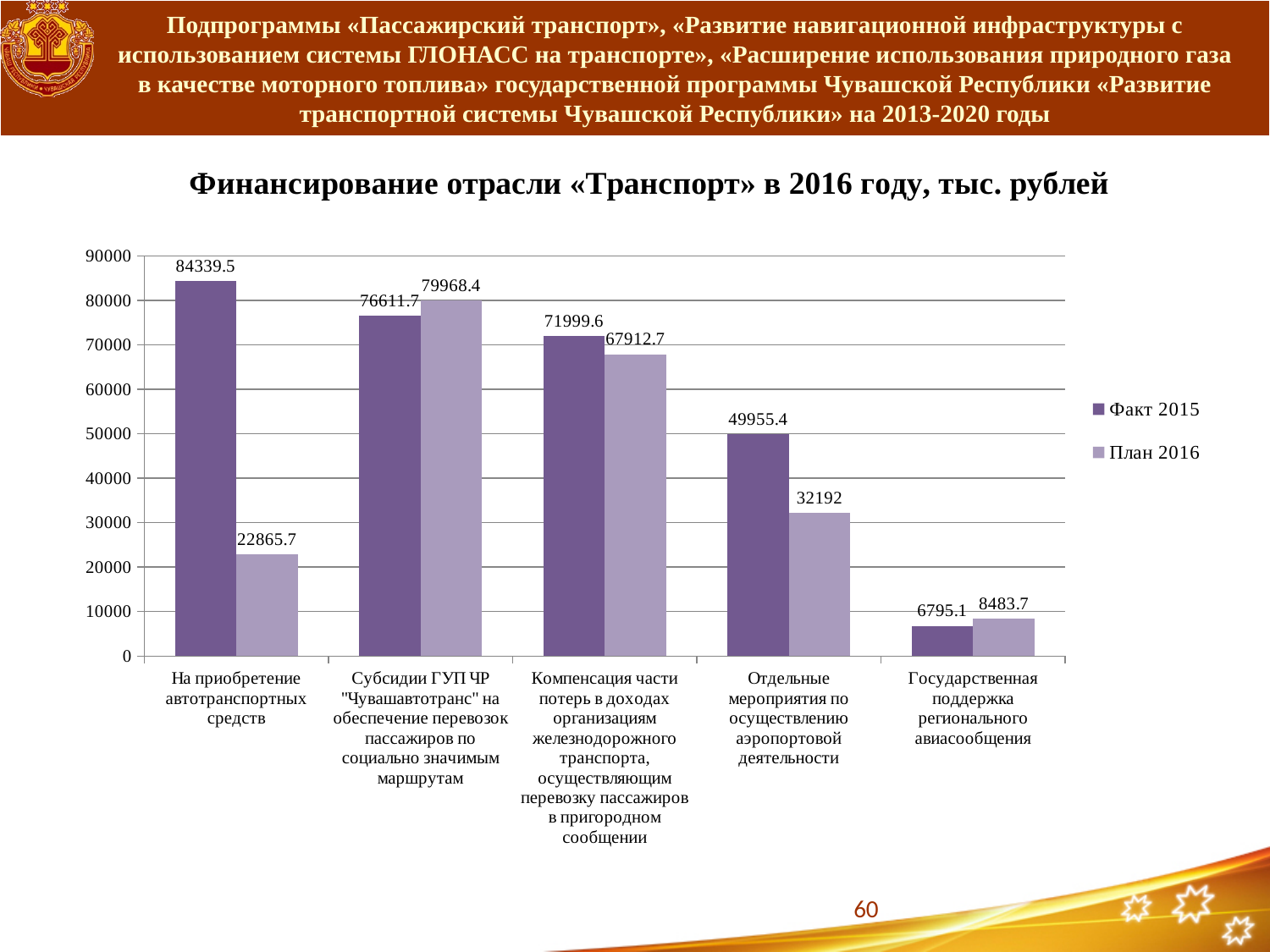
For «Субсидии ГУП ЧР "Чувашавтотранс" на обеспечение перевозок пассажиров по социально значимым маршрутам», which is larger: Факт 2015 or План 2016? План 2016 How many series does the legend list? 2 What is the difference between the Факт 2015 and План 2016 values for «На приобретение автотранспортных средств»? 61473.8 How many categories are shown on the x axis of the chart? 5 What is the План 2016 value for «Государственная поддержка регионального авиасообщения»? 8483.7 Is the Факт 2015 value for «Компенсация части потерь в доходах организациям железнодорожного транспорта» greater or less than 70000? greater Which category has the lowest План 2016 value? Государственная поддержка регионального авиасообщения What is the Факт 2015 value for «На приобретение автотранспортных средств»? 84339.5 What is the difference between the Факт 2015 and План 2016 values for «Отдельные мероприятия по осуществлению аэропортовой деятельности»? 17763.4 What type of chart is shown on the slide? bar chart Which category has the highest Факт 2015 value? На приобретение автотранспортных средств What is the План 2016 value for «Отдельные мероприятия по осуществлению аэропортовой деятельности»? 32192